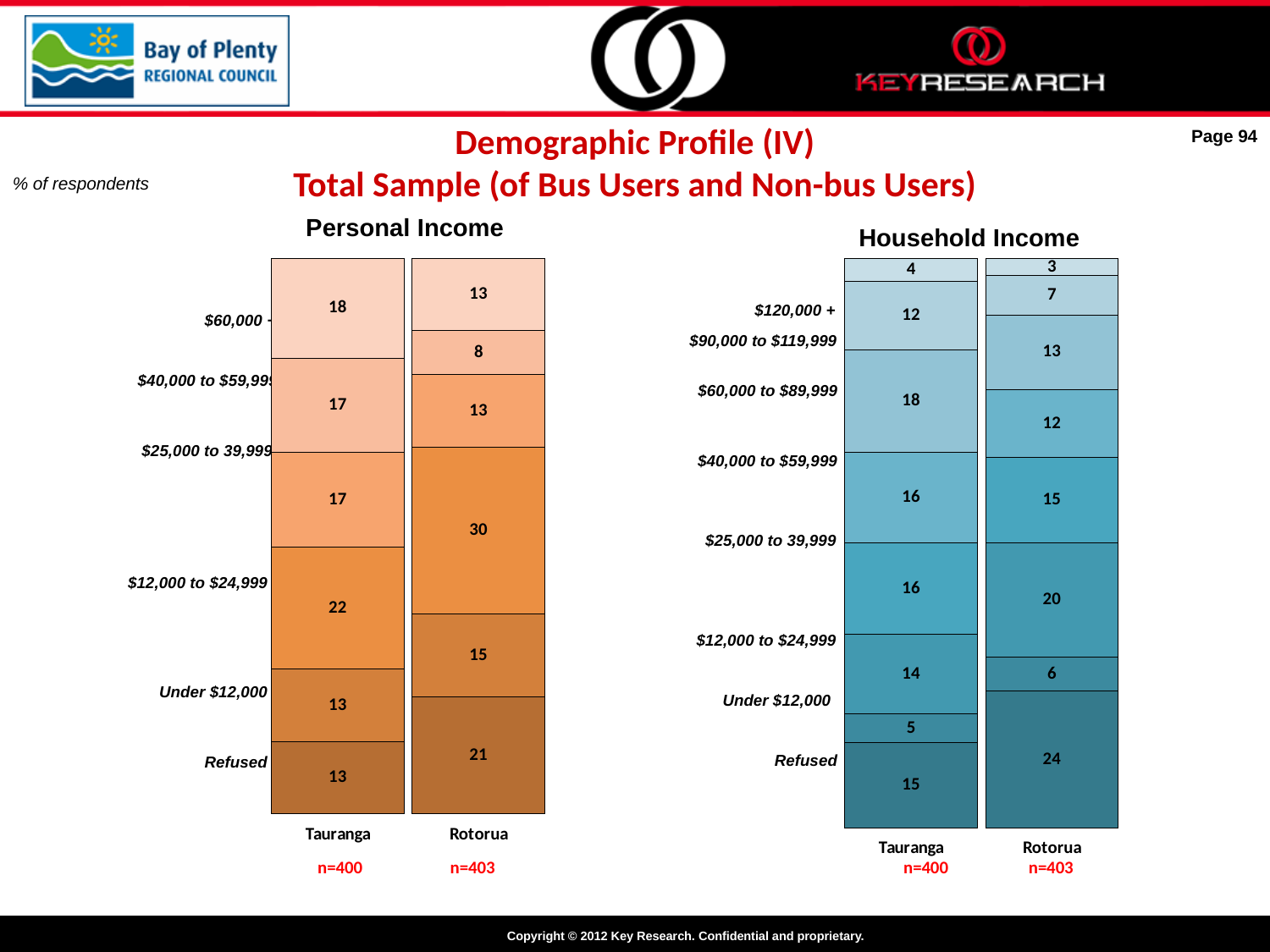
In the Personal Income chart, what is the value of the top ($60,000 +) segment of the Tauranga bar? 18 In the Household Income chart, what is the value of the top ($120,000 +) segment of the Rotorua bar? 3 In the Personal Income chart, what is the value of the largest segment in the Rotorua bar? 30 In the Household Income chart, what is the value of the bottom (Refused) segment of the Tauranga bar? 15 In the Personal Income chart, what is the value of the bottom (Refused) segment of the Rotorua bar? 21 How many bars does the Personal Income chart show? 2 In the Household Income chart, which bar has the larger Refused segment, Tauranga or Rotorua? Rotorua What type of chart is used for Household Income? Stacked bar chart In the Household Income chart, what is the value of the largest segment in the Tauranga bar? 18 In the Household Income chart, what is the value of the bottom (Refused) segment of the Rotorua bar? 24 In the Personal Income chart, what is the difference between the Refused segments of Rotorua (21) and Tauranga (13)? 8 In the Personal Income chart, what is the value of the bottom (Refused) segment of the Tauranga bar? 13